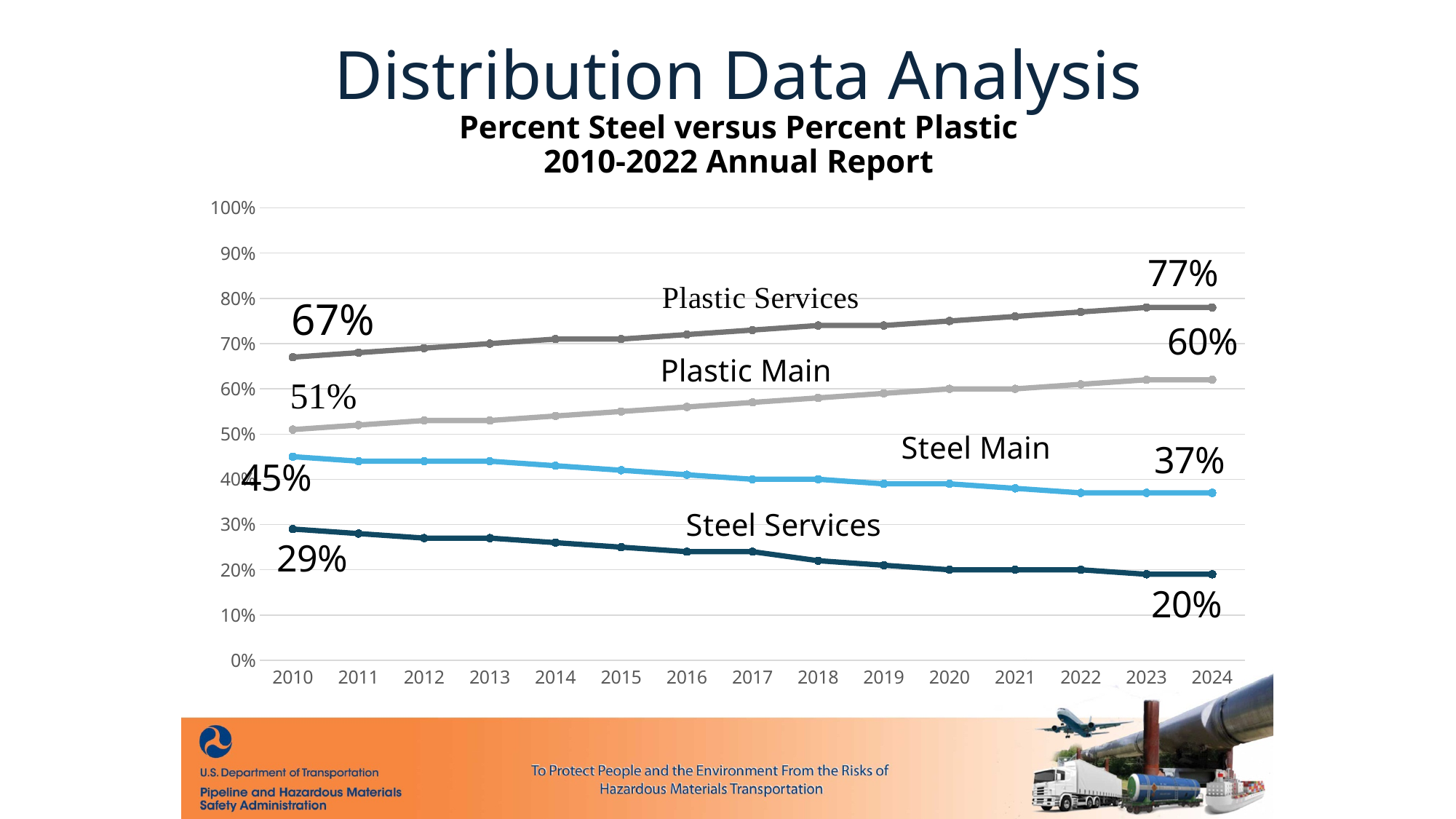
What is the value for Plastic Services in 2010? 67% What is the value for Plastic Main in 2010? 51% Which series has the highest value in 2024? Plastic Services What kind of chart is shown on the slide? Line chart Does the Steel Main line rise or fall from 2010 to 2024? Fall What is the value for Steel Main in 2024? 37% How many series are plotted on the chart? 4 What is the value for Steel Services in 2010? 29% Which series has the lowest value in 2010? Steel Services What is the value for Steel Main in 2010? 45%